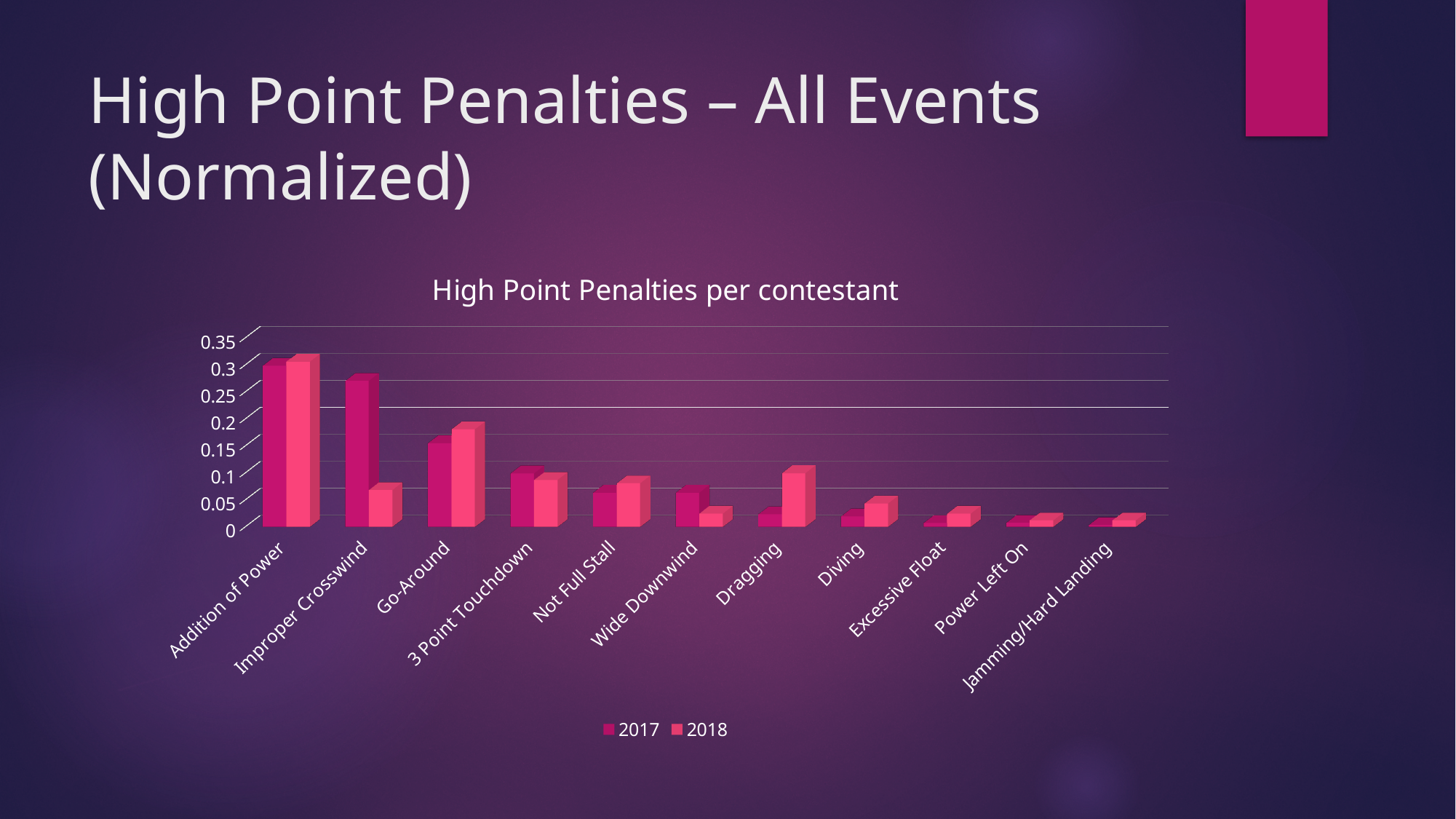
What kind of chart is shown on the slide? Bar chart Is the 2017 value for Improper Crosswind greater or less than 0.2? greater What is the title of the chart? High Point Penalties per contestant For Improper Crosswind, which year has the larger value, 2017 or 2018? 2017 For Dragging, which year has the larger value, 2017 or 2018? 2018 Which category has the highest 2017 value? Addition of Power Is the 2017 value for Addition of Power greater or less than 0.25? greater Is the 2018 value for Wide Downwind greater or less than 0.05? less Which category has the highest 2018 value? Addition of Power How many series does the legend list? 2 Do the 2017 values generally rise or fall moving left to right along the x axis? fall How many penalty categories are shown on the x axis? 11